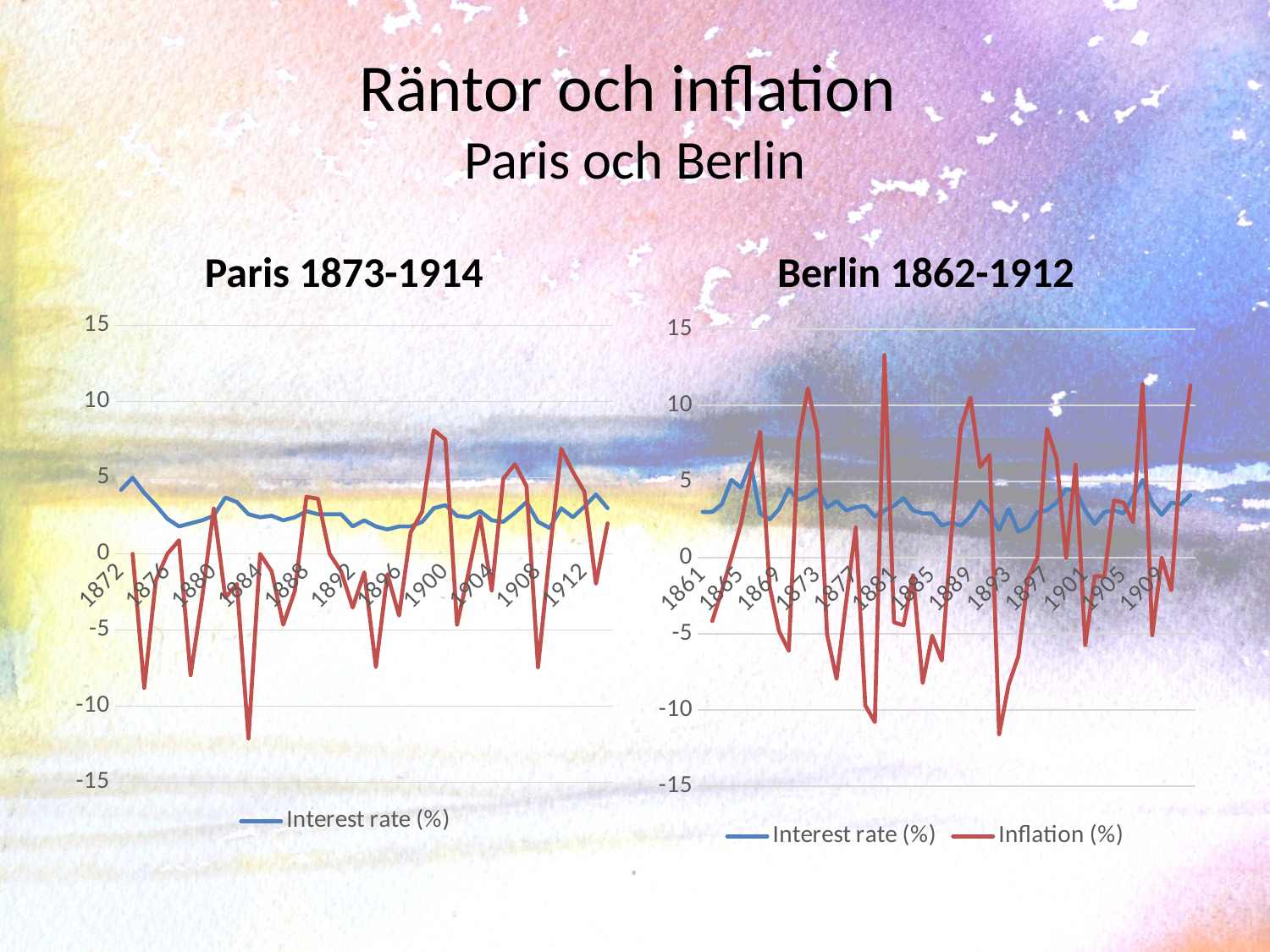
How many series does the legend of the Berlin 1862-1912 chart list? 2 In the Berlin 1862-1912 chart, which series has the larger swings between high and low values, Interest rate (%) or Inflation (%)? Inflation (%) In the Berlin 1862-1912 chart, is the highest value of the Interest rate (%) line greater or less than 10? less What is the title of the chart on the left side of the slide? Paris 1873-1914 In the Berlin 1862-1912 chart, which series is drawn in red? Inflation (%) In the Berlin 1862-1912 chart, is the highest value of the Inflation (%) line greater or less than 10? greater What kind of chart is the Paris 1873-1914 chart? line chart In the Paris 1873-1914 chart, is the highest value of the Interest rate (%) line greater or less than 10? less How many series does the legend of the Paris 1873-1914 chart list? 1 What kind of chart is the Berlin 1862-1912 chart? line chart